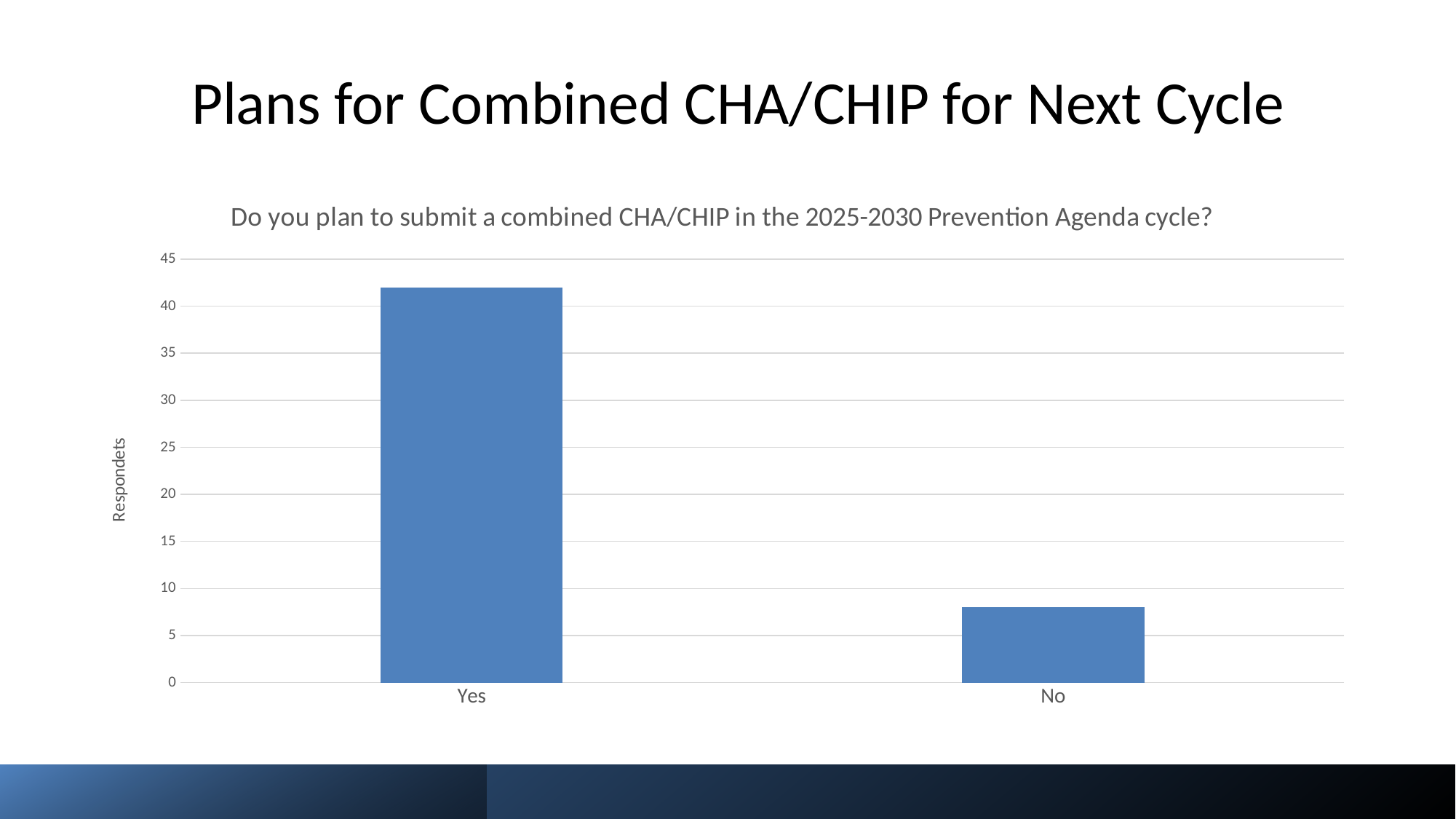
What is the label on the vertical axis of the chart? Respondets Is the value for Yes greater or less than 45? less Which category has the highest number of respondents? Yes Which has more respondents, Yes or No? Yes What is the title of the chart? Do you plan to submit a combined CHA/CHIP in the 2025-2030 Prevention Agenda cycle? What kind of chart is shown on the slide? bar chart Is the value for No greater or less than 10? less How many categories are shown on the x axis of the chart? 2 Is the value for Yes greater or less than 40? greater Which category has the lowest number of respondents? No